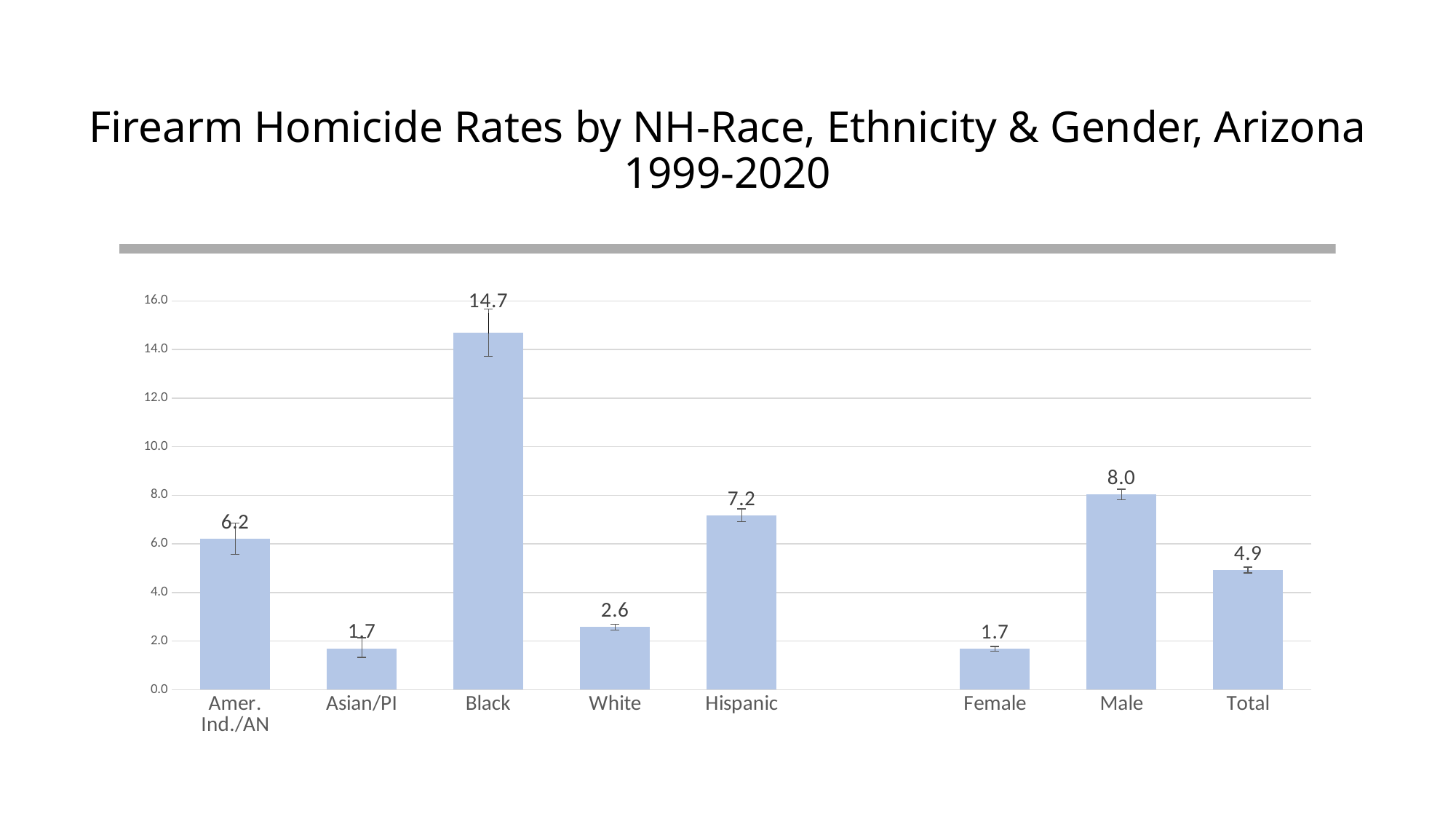
Is the value for Black greater or less than 12.0? greater What is the firearm homicide rate for Black in the chart? 14.7 What is the value shown for Total? 4.9 What is the difference between the Black and White rates? 12.1 What is the difference between the Male and Female rates? 6.3 What kind of chart is shown on the slide? bar chart Which is larger, the rate for Amer. Ind./AN or the rate for Hispanic? Hispanic How many bars are plotted in the chart? 8 What is the firearm homicide rate for Hispanic? 7.2 What is the value shown for Male? 8.0 Which category has the lowest value among the race/ethnicity groups (Amer. Ind./AN, Asian/PI, Black, White, Hispanic)? Asian/PI Which category has the highest firearm homicide rate? Black